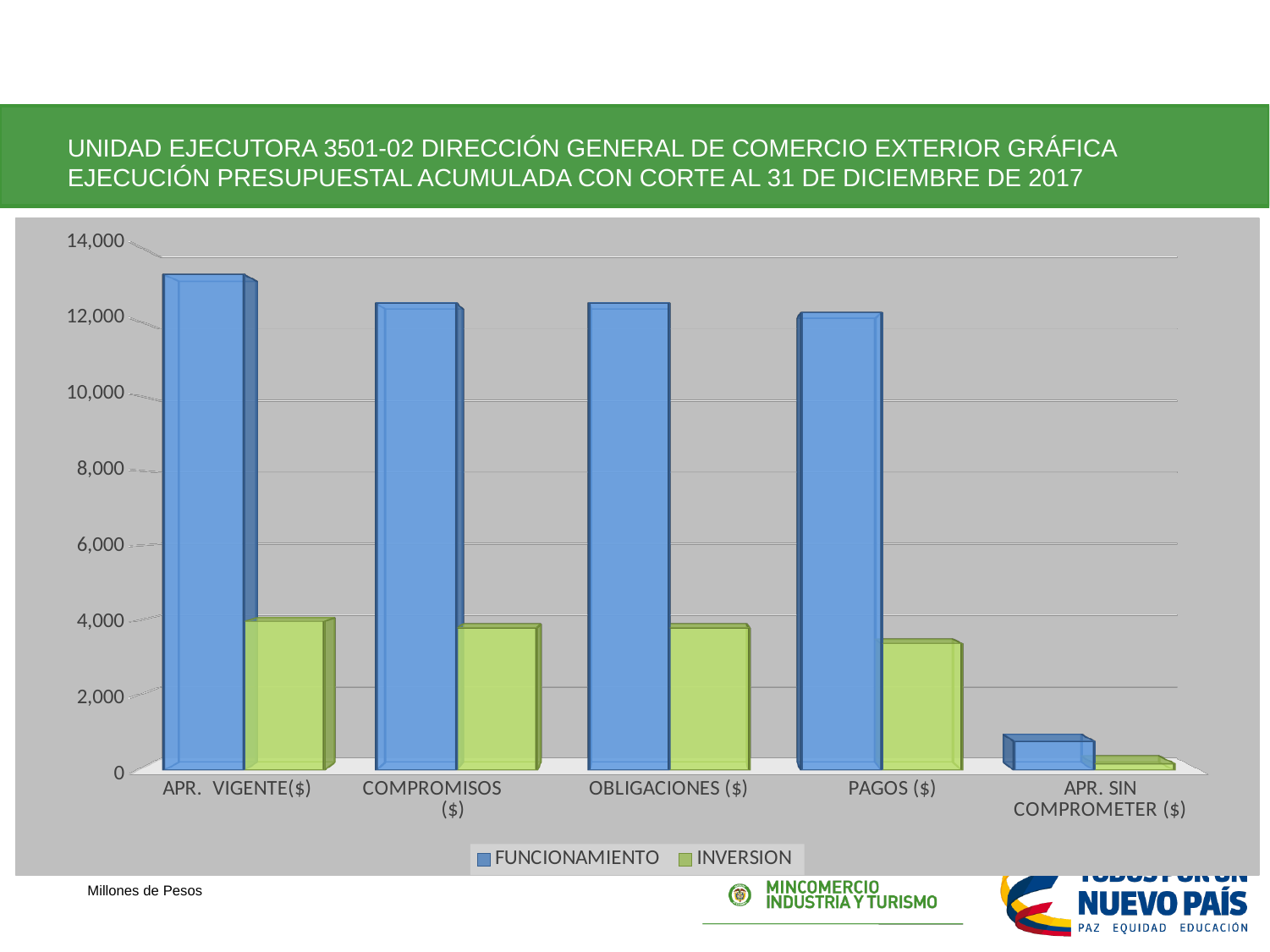
How many categories are shown on the x axis of the chart? 5 Is the INVERSION value for PAGOS ($) greater or less than 4,000? less Is the FUNCIONAMIENTO value for PAGOS ($) greater or less than 10,000? greater How many series does the chart's legend list? 2 Which category has the highest FUNCIONAMIENTO value? APR. VIGENTE($) What kind of chart is shown on the slide? bar chart Which category has the lowest INVERSION value? APR. SIN COMPROMETER ($) Which category has the lowest FUNCIONAMIENTO value? APR. SIN COMPROMETER ($) For PAGOS ($), which series has the larger value, FUNCIONAMIENTO or INVERSION? FUNCIONAMIENTO Is the FUNCIONAMIENTO value for APR. SIN COMPROMETER ($) greater or less than 2,000? less Which colour represents the INVERSION series in the chart? green